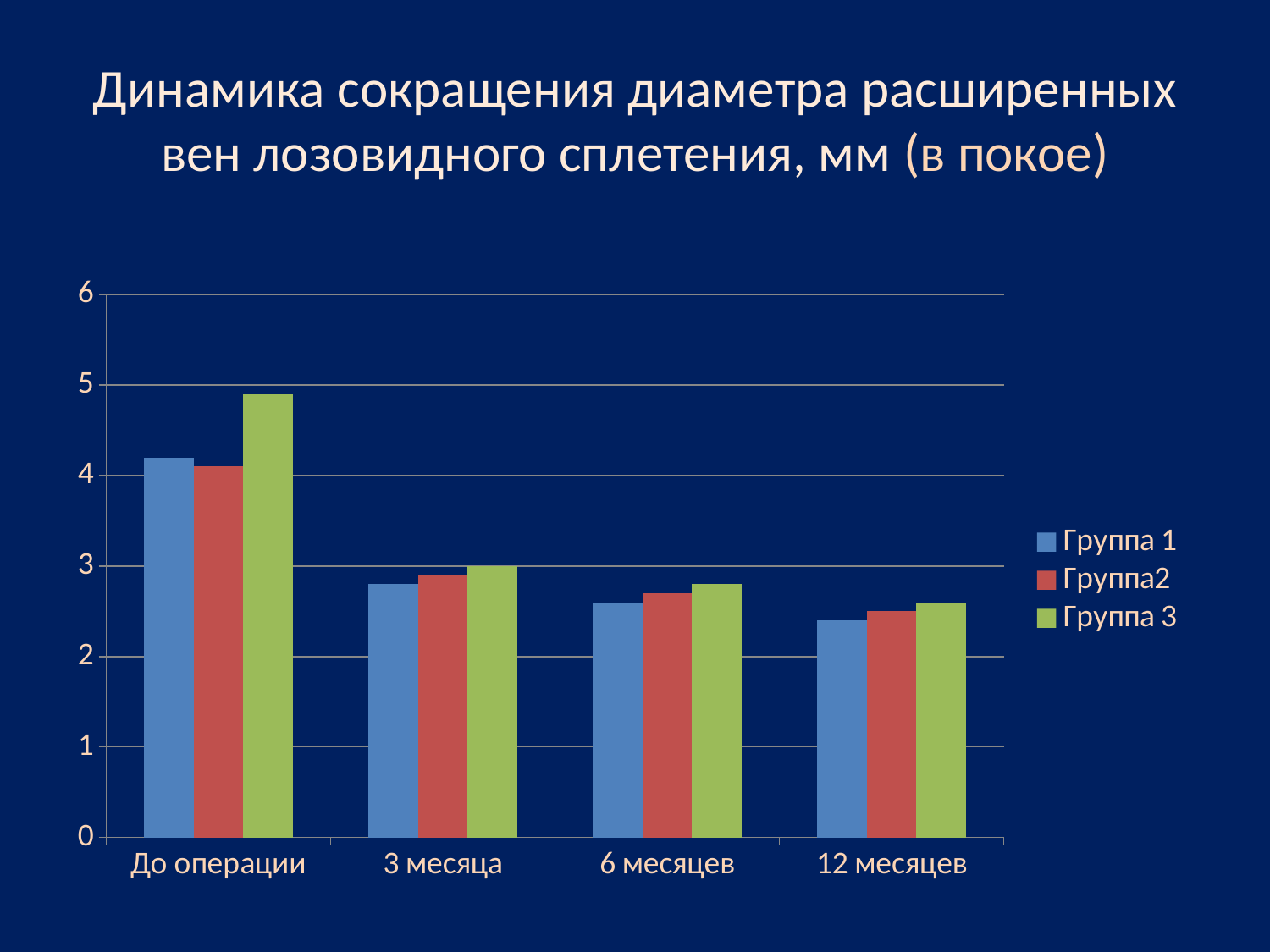
Is the value for Группа 1 in the '12 месяцев' category greater or less than 3? less Do the values for Группа 1 rise or fall from 'До операции' to '12 месяцев'? fall Which category has the highest values for all three groups? До операции Is the value for Группа 3 in the 'До операции' category greater or less than 4? greater Is the value for Группа 2 in the '6 месяцев' category greater or less than 2? greater Which group has the highest value in the 'До операции' category? Группа 3 How many categories are shown on the x axis? 4 What colour are the bars for Группа 3? green How many series does the legend list? 3 What kind of chart is shown on the slide? bar chart Which group has the lowest value in the '12 месяцев' category? Группа 1 Which is larger: the value for Группа 3 in 'До операции' or the value for Группа 3 in '3 месяца'? До операции